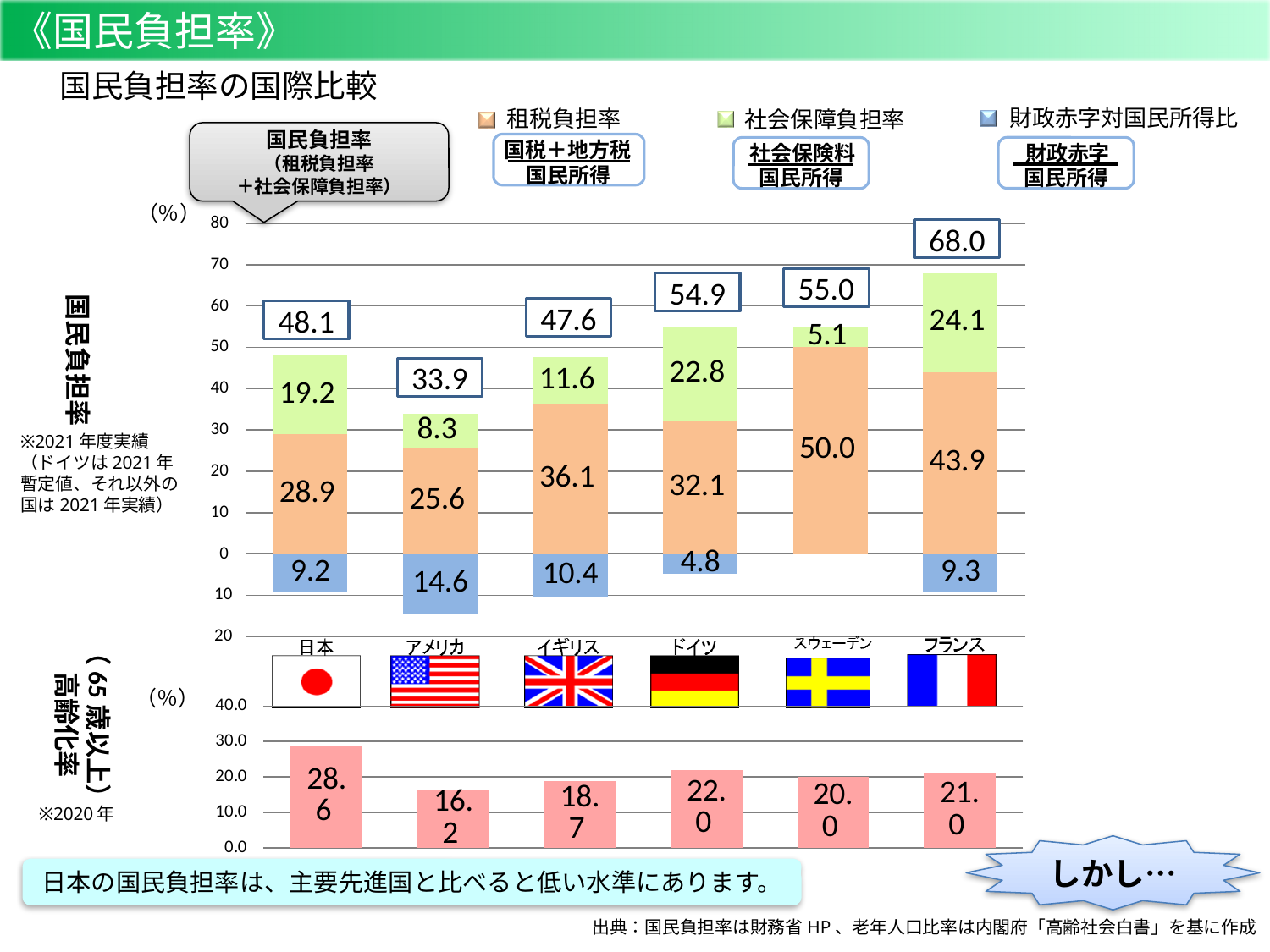
In the top chart (国民負担率の国際比較), what is the 社会保障負担率 value for フランス? 24.1 In the bottom chart (高齢化率), which country has the lowest value? アメリカ In the bottom chart (高齢化率), what is the value for 日本? 28.6 In the top chart (国民負担率の国際比較), what is the 国民負担率 value shown for 日本? 48.1 In the top chart (国民負担率の国際比較), which is larger, the 財政赤字対国民所得比 for アメリカ or for イギリス? アメリカ In the top chart (国民負担率の国際比較), what is the difference between the 国民負担率 of フランス and 日本? 19.9 In the top chart (国民負担率の国際比較), what is the 租税負担率 value for スウェーデン? 50.0 What kind of chart is the bottom chart (高齢化率)? bar chart In the top chart (国民負担率の国際比較), which country has the highest 国民負担率? フランス How many countries are shown in the top chart (国民負担率の国際比較)? 6 In the top chart (国民負担率の国際比較), which country has the lowest 国民負担率? アメリカ How many series does the legend of the top chart (国民負担率の国際比較) list? 3